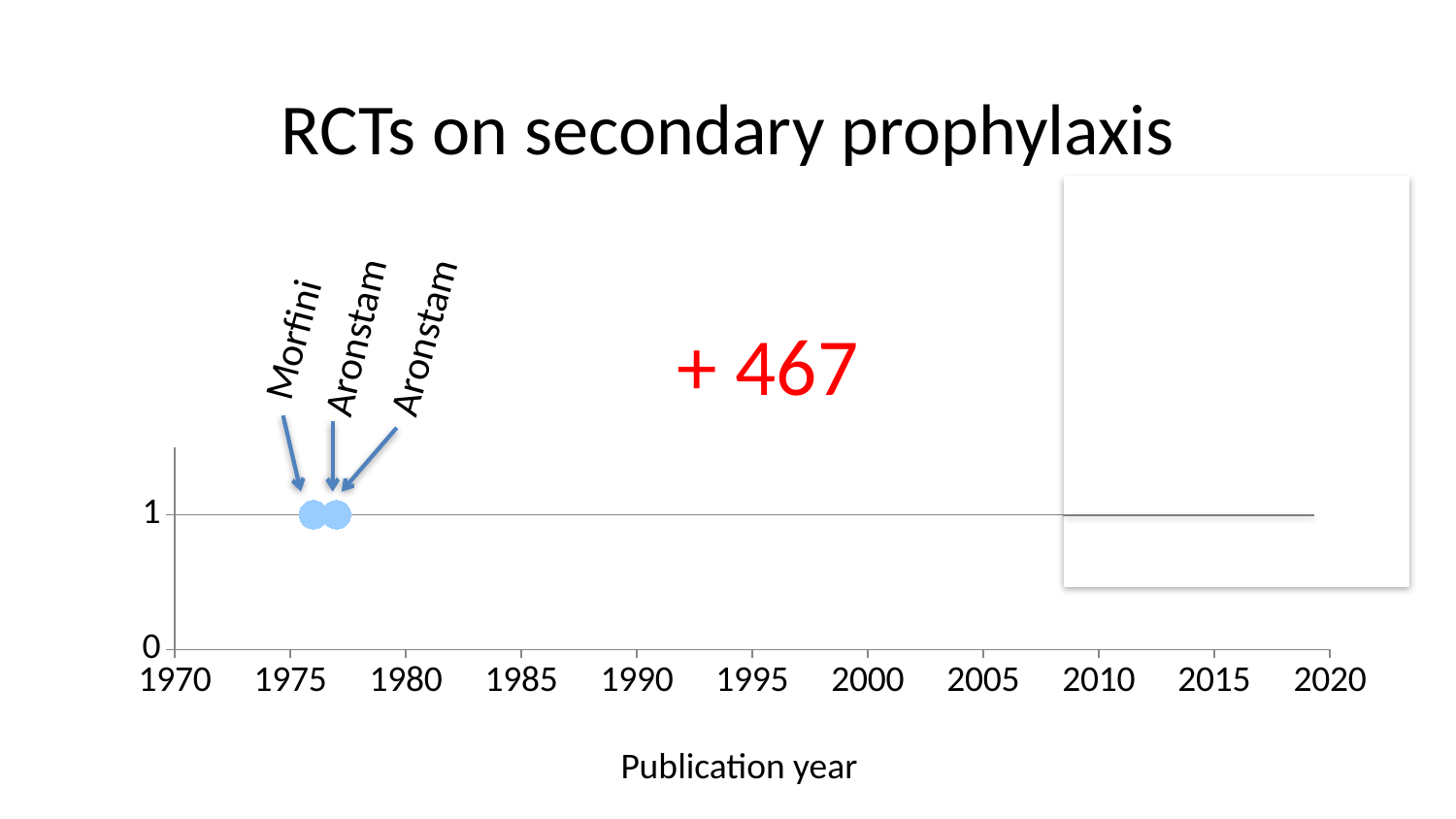
What is the first year shown on the x axis? 1970 What is the highest tick value shown on the y axis? 1 Which labeled study is the earliest on the x axis? Morfini What kind of chart is shown on the slide? scatter chart What is the last year shown on the x axis? 2020 What is the title of the chart? RCTs on secondary prophylaxis How many labeled study points are marked with arrows on the chart? 3 How many of the labeled points are attributed to Aronstam? 2 What is the label of the x axis? Publication year Are the labeled study points plotted before or after 1980 on the x axis? before What y-axis value do the plotted points sit on? 1 What red annotation text appears on the chart? + 467